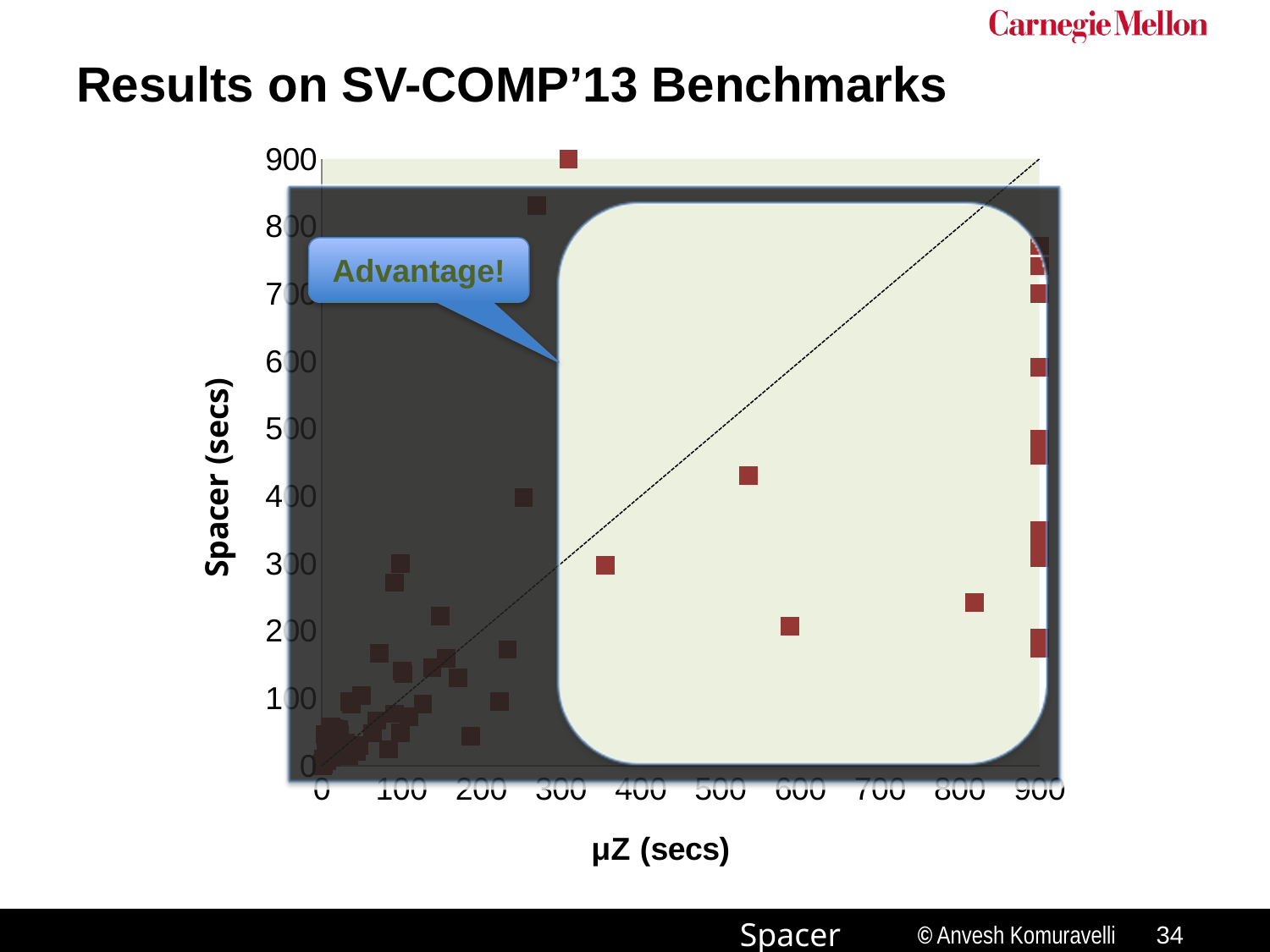
What kind of chart is shown on the slide? scatter plot What is the label of the y axis of the chart? Spacer (secs) What is the label of the x axis of the chart? μZ (secs) Is the topmost point on the chart greater or less than 800 on the Spacer (secs) axis? greater Is the point plotted at roughly 800 on the μZ axis greater or less than 300 on the Spacer (secs) axis? less What is the highest tick value shown on the y axis? 900 What is the highest tick value shown on the x axis? 900